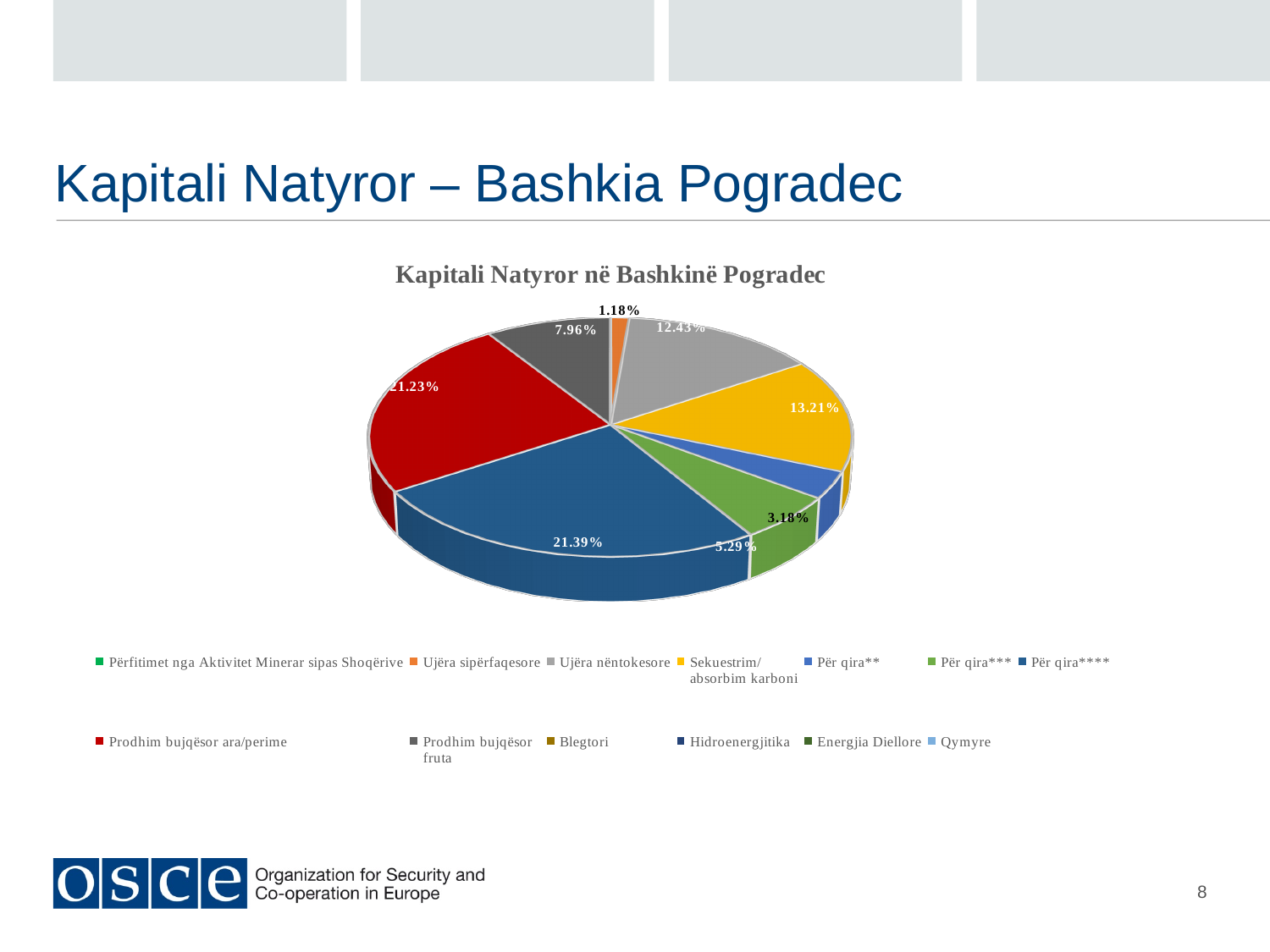
What percentage is shown for the Prodhim bujqësor fruta (dark grey) slice? 7.96% What is the difference between the Sekuestrim/absorbim karboni slice (13.21%) and the Ujëra nëntokesore slice (12.43%)? 0.78% Which slice has the largest labelled share in the pie? Për qira**** (21.39%) What percentage is shown for the Sekuestrim/absorbim karboni (yellow) slice? 13.21% Which slice has the smallest labelled share in the pie? Ujëra sipërfaqesore (1.18%) What percentage is shown for the Për qira*** (green) slice? 5.29% What percentage is shown for the Për qira**** (dark blue) slice? 21.39% What percentage is shown for the Ujëra sipërfaqesore (orange) slice? 1.18% What is the title of the chart? Kapitali Natyror në Bashkinë Pogradec How many entries does the legend list? 13 What type of chart is shown on the slide? Pie chart What percentage is shown for the Prodhim bujqësor ara/perime (red) slice? 21.23%